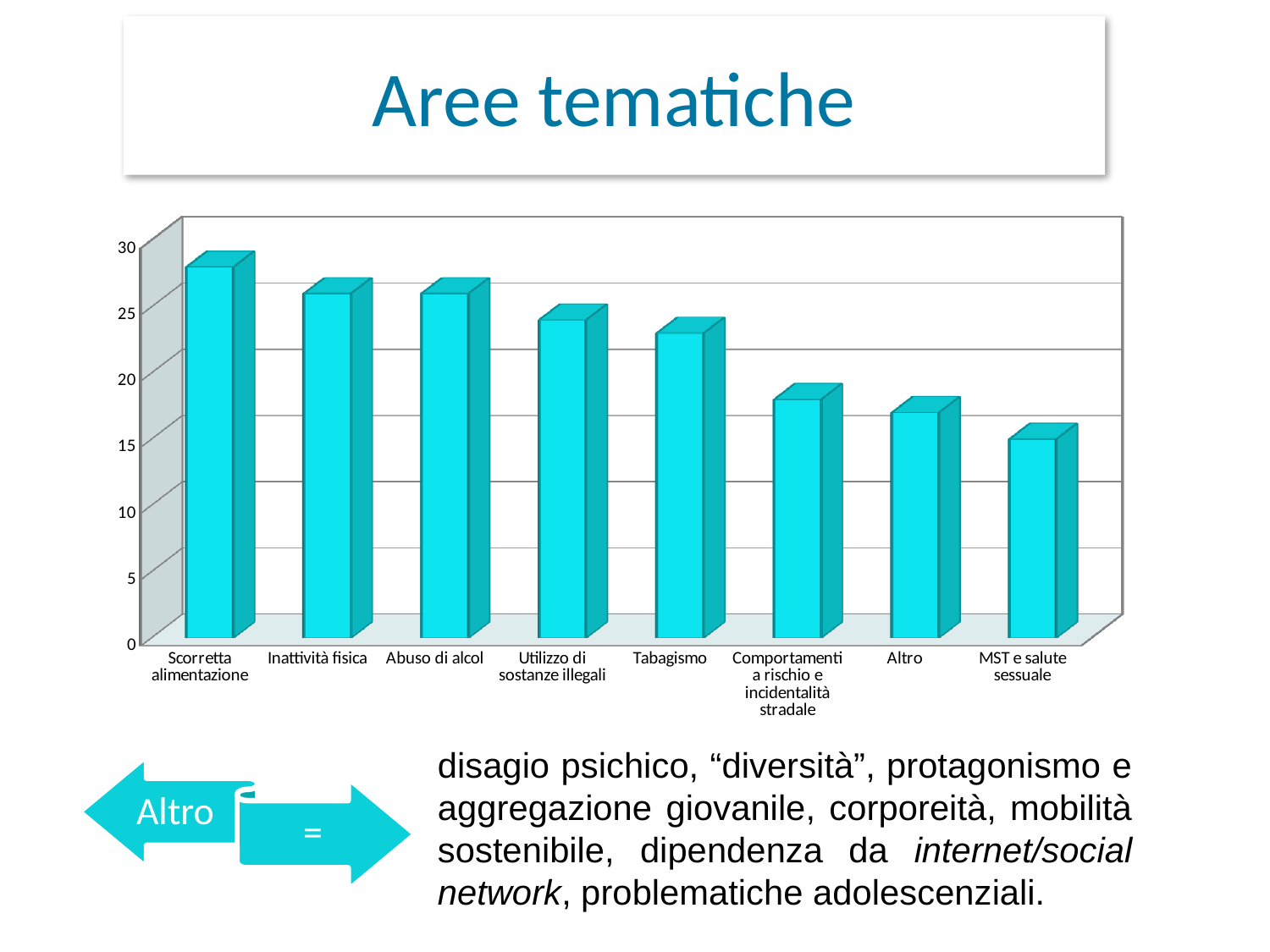
Which category has the lowest value in the chart? MST e salute sessuale How many categories are shown on the x axis of the chart? 8 Is the value for Scorretta alimentazione greater or less than 25? greater Is the value for Altro greater or less than 15? greater Which is larger, the value for Altro or the value for Scorretta alimentazione? Scorretta alimentazione Do the values rise or fall moving from left to right along the x axis? Fall Which category has the highest value in the chart? Scorretta alimentazione Is the value for Tabagismo greater or less than 25? less What kind of chart is shown on the slide? Bar chart Which is larger, the value for Tabagismo or the value for Comportamenti a rischio e incidentalità stradale? Tabagismo